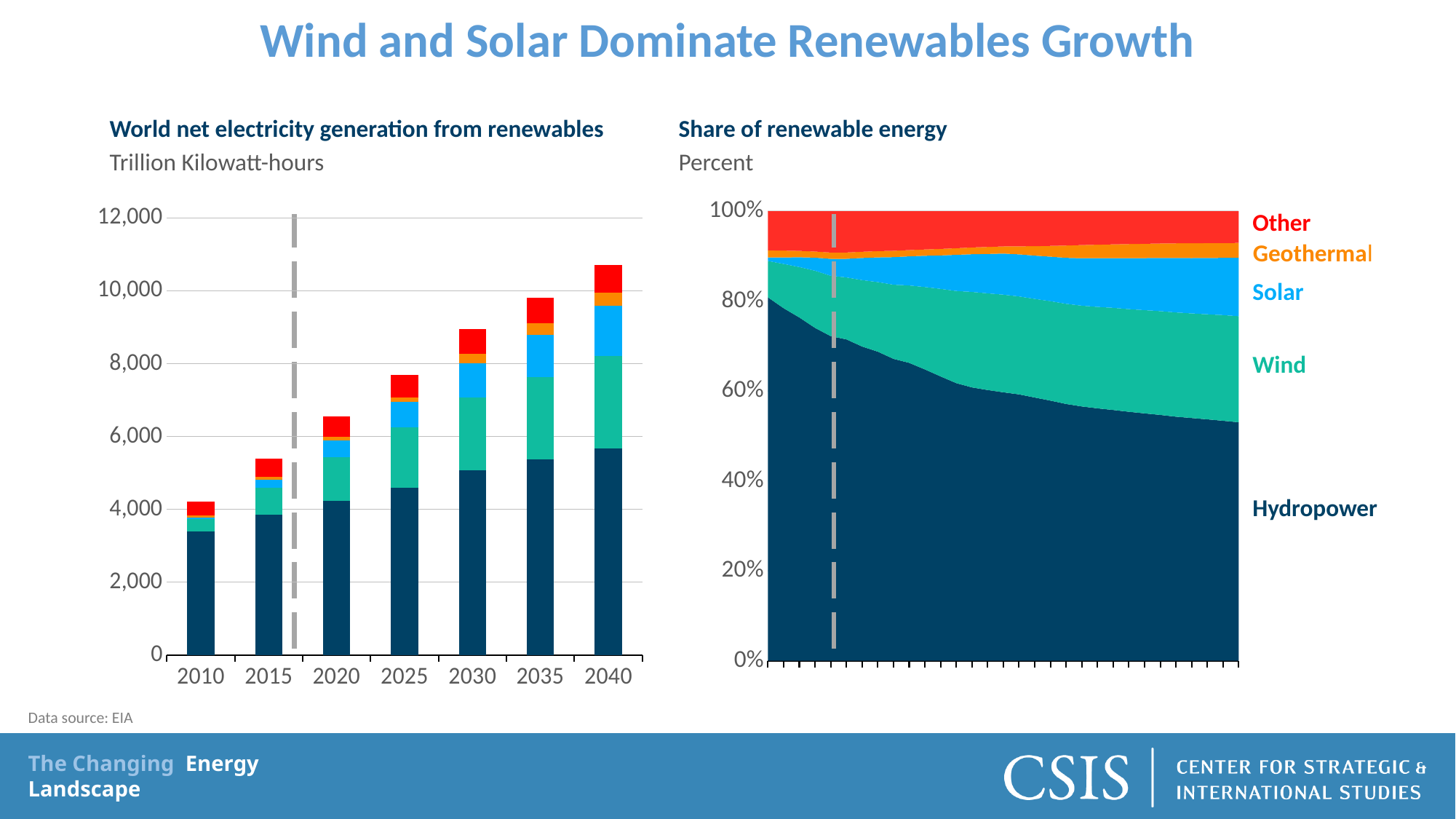
What kind of chart is the left chart, 'World net electricity generation from renewables'? stacked bar chart In the right chart, 'Share of renewable energy', does the Hydropower share rise or fall over time? fall In the right chart, 'Share of renewable energy', is the Hydropower share at the right end of the chart greater or less than 60%? less In the left chart, 'World net electricity generation from renewables', how many years are shown on the x axis? 7 What unit is given for the left chart, 'World net electricity generation from renewables'? Trillion Kilowatt-hours What kind of chart is the right chart, 'Share of renewable energy'? stacked area chart In the left chart, 'World net electricity generation from renewables', which year has the lowest total bar? 2010 In the left chart, 'World net electricity generation from renewables', is the total bar for 2040 greater or less than 10,000? greater In the right chart, 'Share of renewable energy', how many energy sources are listed in the legend? 5 In the left chart, 'World net electricity generation from renewables', do the total bars rise or fall from 2010 to 2040? rise In the left chart, 'World net electricity generation from renewables', which year has the highest total bar? 2040 In the left chart, 'World net electricity generation from renewables', is the total bar for 2010 greater or less than 6,000? less